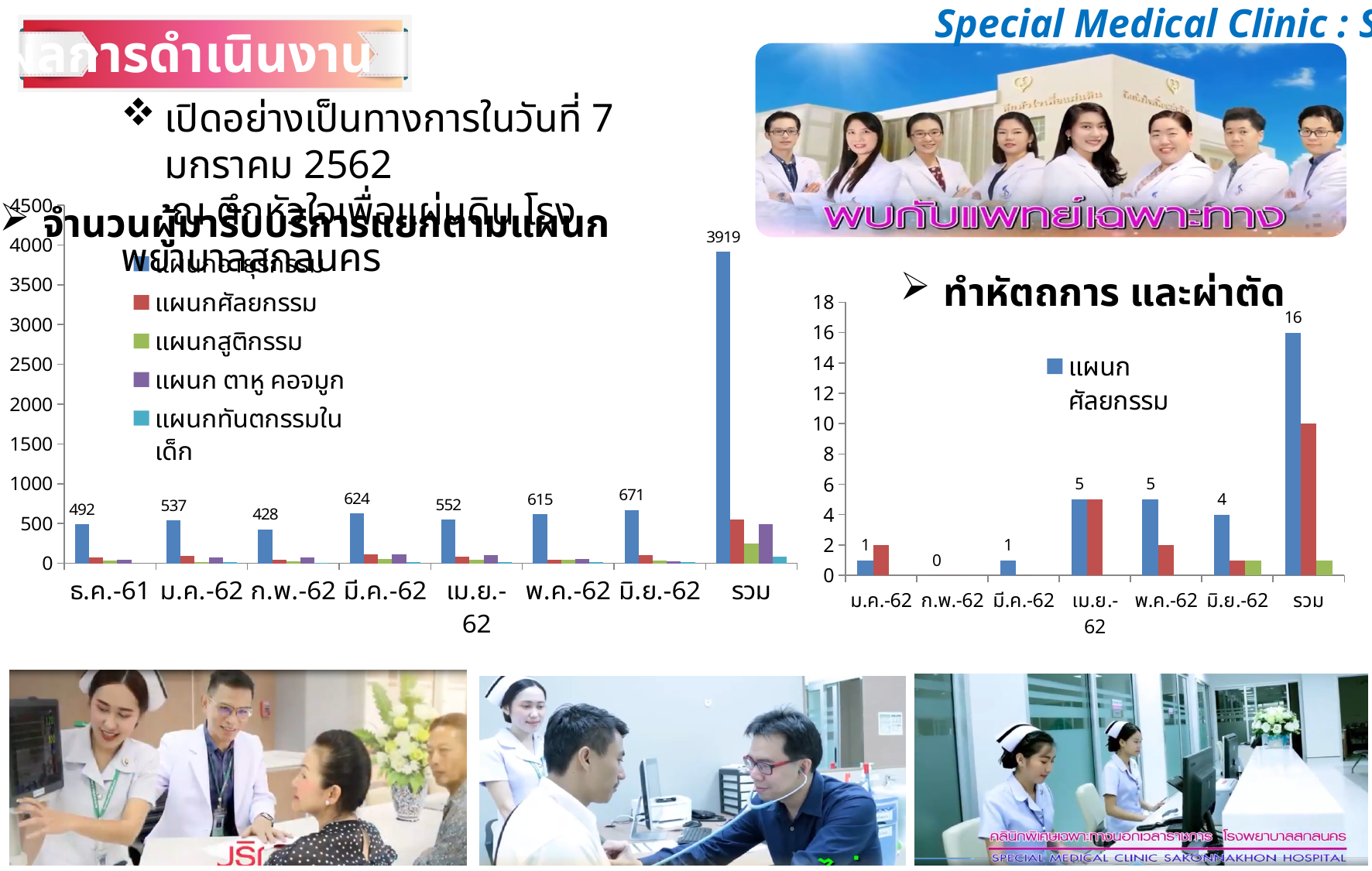
In the left chart, what is the difference between the blue series values for มิ.ย.-62 and ธ.ค.-61? 179 In the left chart, which month (excluding รวม) has the highest value for the blue series? มิ.ย.-62 In the right chart, what is the difference between the blue series values for รวม and มิ.ย.-62? 12 In the left chart, which month has the lowest value for the blue series? ก.พ.-62 How many categories are shown on the x axis of the left chart? 8 In the left chart, what is the value of the blue series for รวม? 3919 What kind of chart is the right chart (ทำหัตถการ และผ่าตัด)? bar chart In the right chart, what is the value of the blue series for รวม? 16 How many series does the legend of the left chart list? 5 In the left chart, what is the value of the blue series for มี.ค.-62? 624 In the left chart, which has the larger blue series value, ม.ค.-62 or เม.ย.-62? เม.ย.-62 In the right chart, is the red bar for รวม greater or less than 8? greater